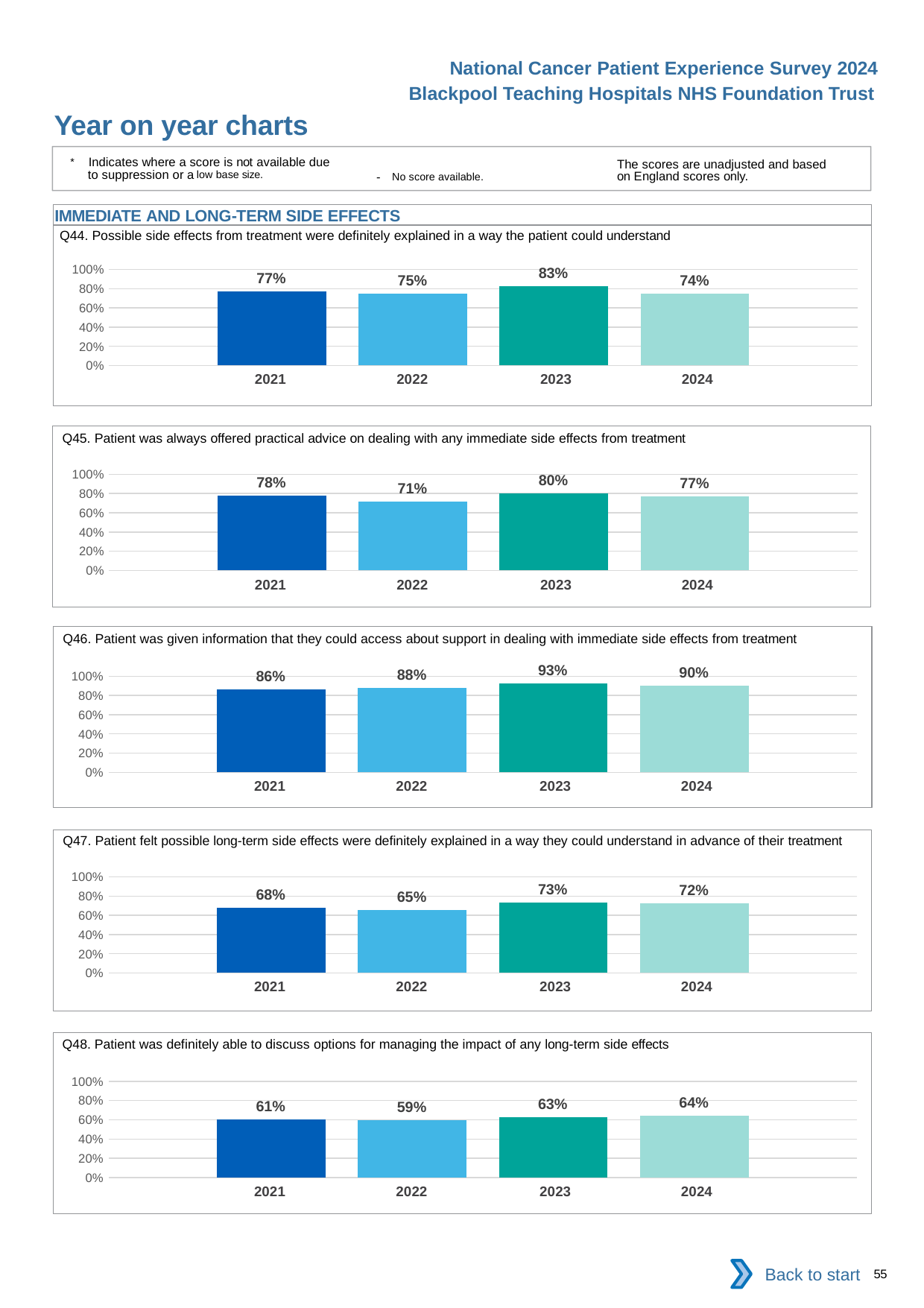
In the Q48 chart, which year has the highest value? 2024 In the Q45 chart, which year has the lowest value? 2022 In the Q44 chart, what is the value for 2023? 83% What kind of chart is the Q45 chart? bar chart In the Q46 chart, is the value for 2024 greater or less than 80%? greater In the Q47 chart, which is larger, the value for 2021 or the value for 2022? 2021 In the Q45 chart, what is the value for 2024? 77% What is the section heading above the Q44 chart? IMMEDIATE AND LONG-TERM SIDE EFFECTS In the Q46 chart, what is the difference between the 2023 and 2021 values? 7% In the Q47 chart, what is the difference between the 2023 and 2022 values? 8% In the Q48 chart, what is the value for 2022? 59% How many bars are plotted in the Q44 chart? 4